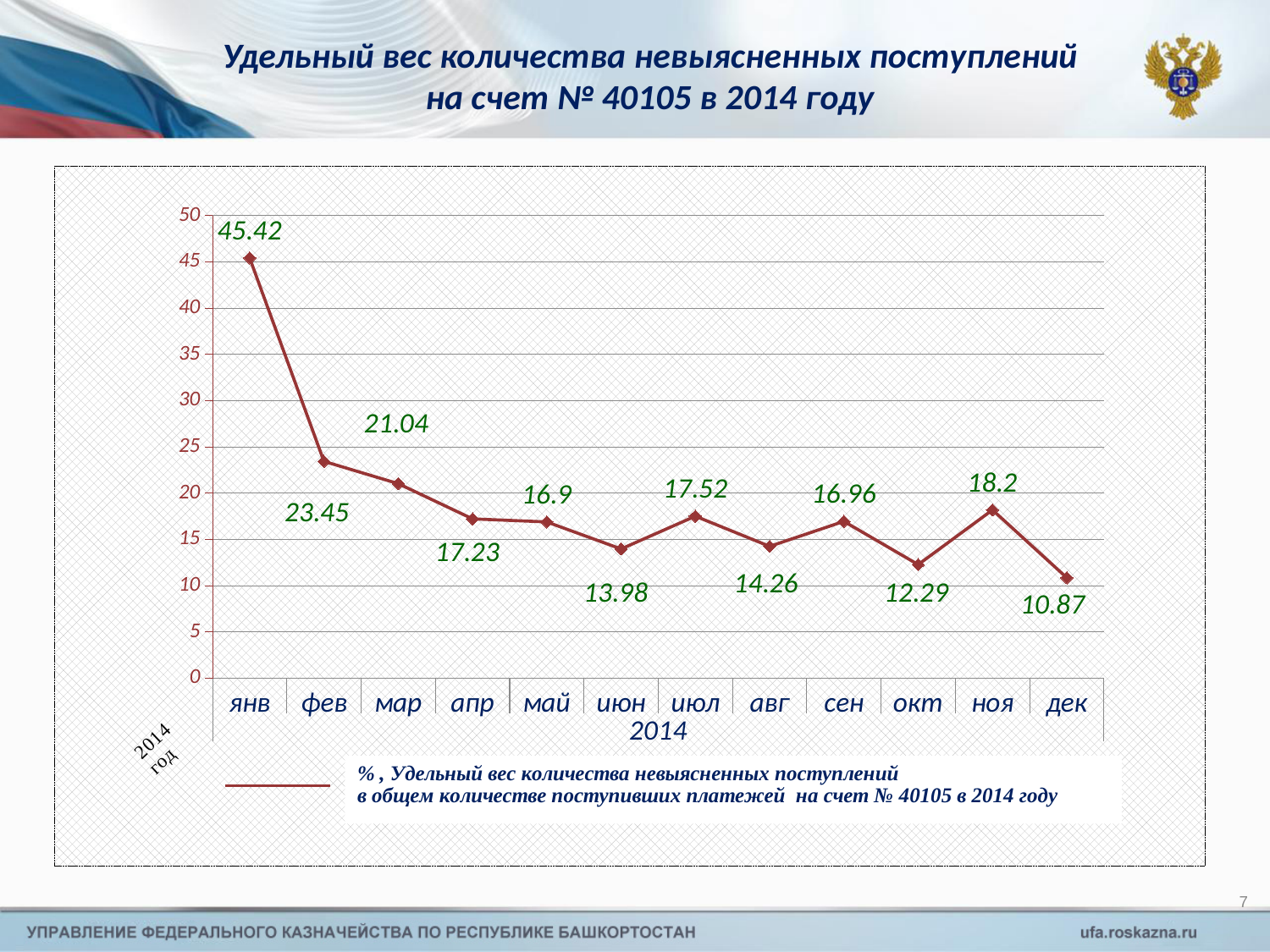
Which month has the lowest value? дек What is the value for янв (January)? 45.42 What is the value for дек (December)? 10.87 What kind of chart is shown on the slide? line chart What is the difference between the values for ноя and дек? 7.33 Which month has the highest value? янв Which is larger, the value for июн or the value for авг? авг Is the value for мар greater or less than 20? greater What is the value for июл (July)? 17.52 What is the difference between the values for янв and фев? 21.97 How many months are plotted on the chart? 12 Do the values generally rise or fall from янв to дек? fall